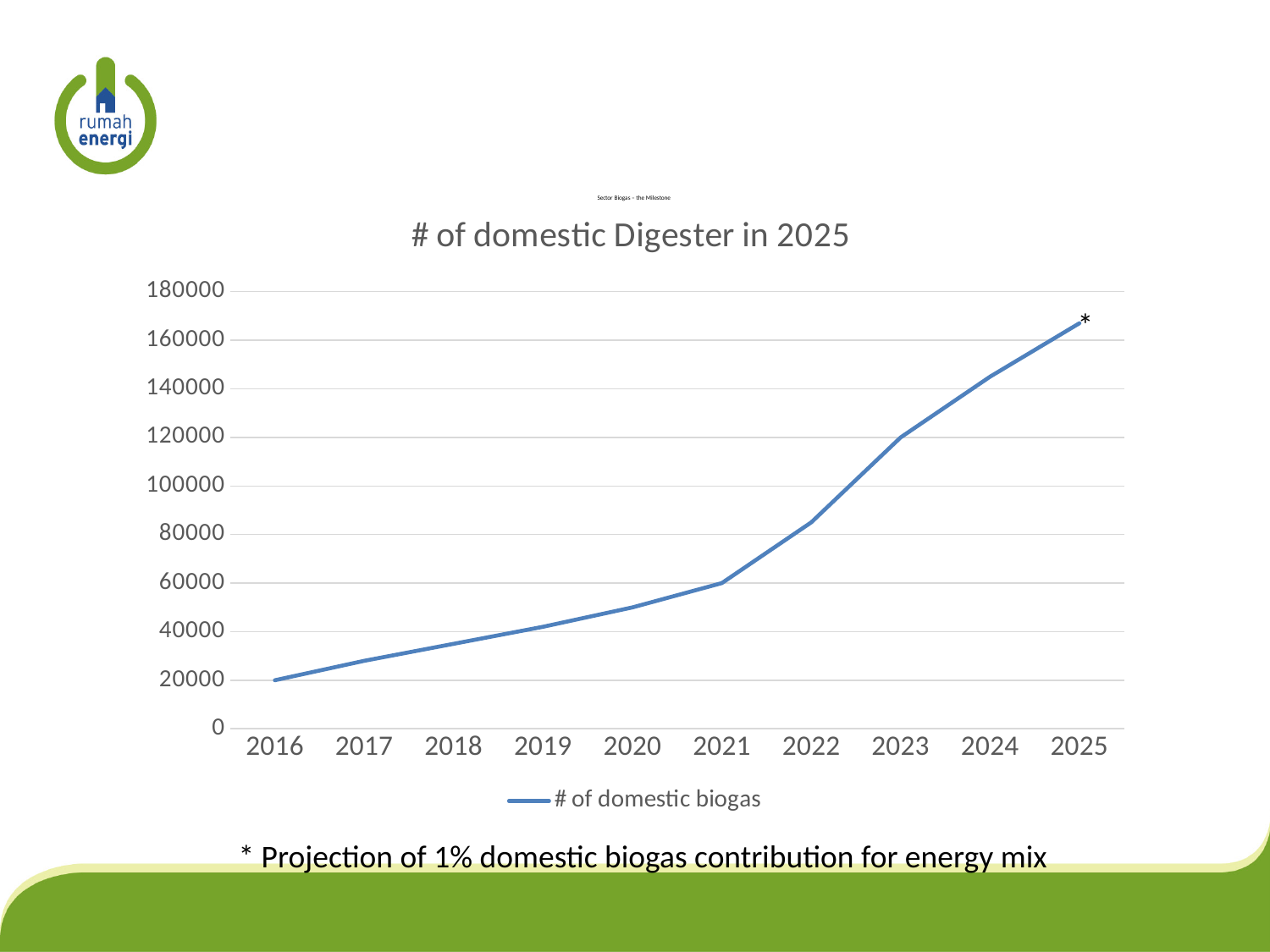
Is the value for 2025 greater or less than 160000? greater What is the name of the series shown in the legend? # of domestic biogas How many series does the legend list? 1 How many years are plotted along the x axis? 10 What is the title of the chart? # of domestic Digester in 2025 Which year has the highest number of domestic biogas digesters? 2025 Do the values rise or fall from 2016 to 2025? rise Is the value for 2018 greater or less than 40000? less What kind of chart is shown on the slide? line chart Which year has the larger value, 2020 or 2023? 2023 Is the value for 2022 greater or less than 80000? greater Which year has the lowest number of domestic biogas digesters? 2016